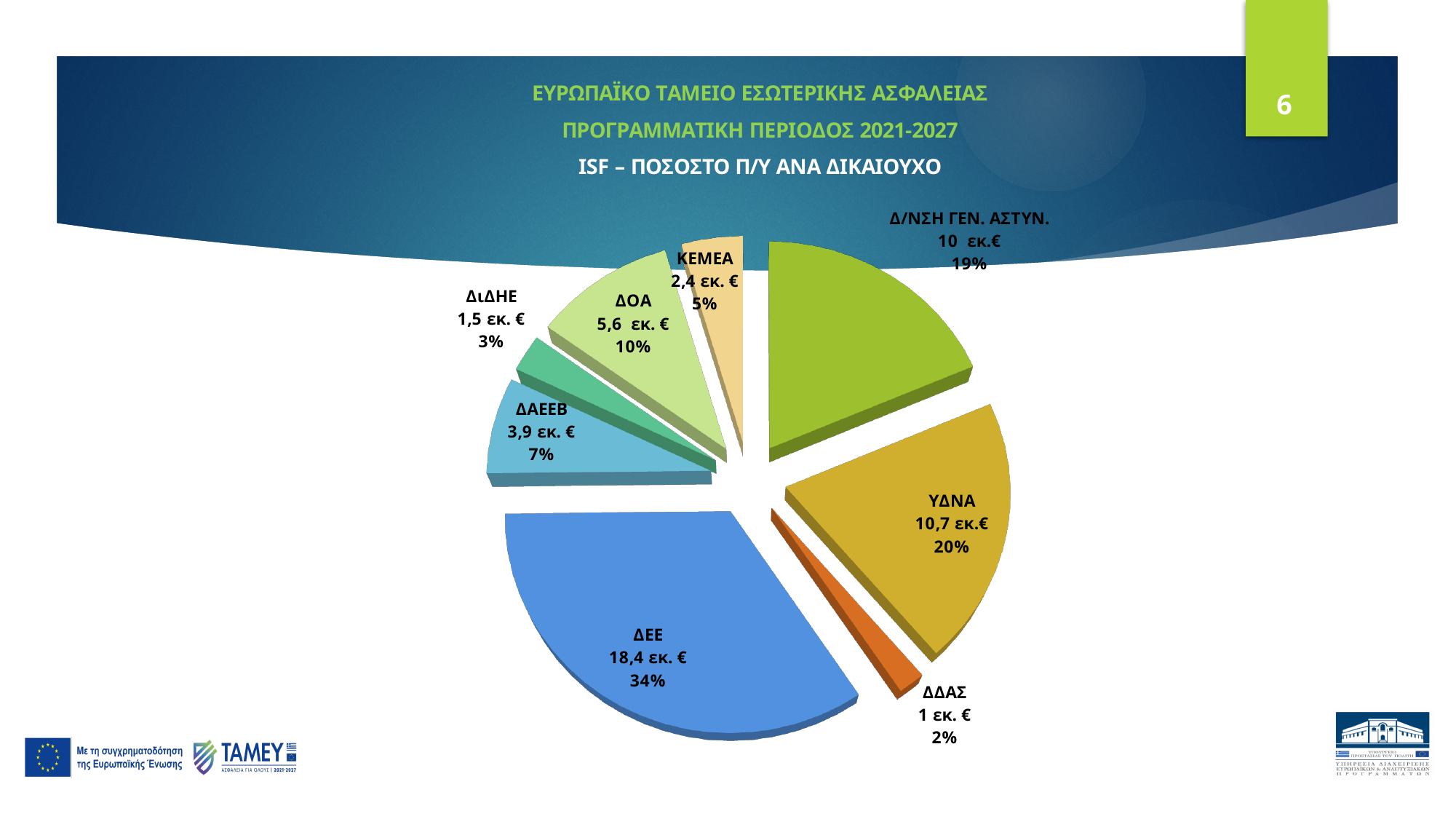
Which has a larger budget, ΔΟΑ or ΔΑΕΕΒ? ΔΟΑ What is the title of the chart shown on the slide? ISF – ΠΟΣΟΣΤΟ Π/Υ ΑΝΑ ΔΙΚΑΙΟΥΧΟ What percentage share does ΥΔΝΑ have in the pie chart? 20% How many slices does the pie chart have? 8 Which beneficiary has the smallest share of the pie chart? ΔΔΑΣ What percentage share does ΚΕΜΕΑ have? 5% What is the budget amount shown for Δ/ΝΣΗ ΓΕΝ. ΑΣΤΥΝ.? 10 εκ.€ What is the budget amount shown for ΔιΔΗΕ? 1,5 εκ. € What is the budget amount shown for ΔΕΕ? 18,4 εκ. € Which beneficiary has the largest share of the pie chart? ΔΕΕ What is the difference in percentage share between ΥΔΝΑ and Δ/ΝΣΗ ΓΕΝ. ΑΣΤΥΝ.? 1% What type of chart is shown on the slide? pie chart